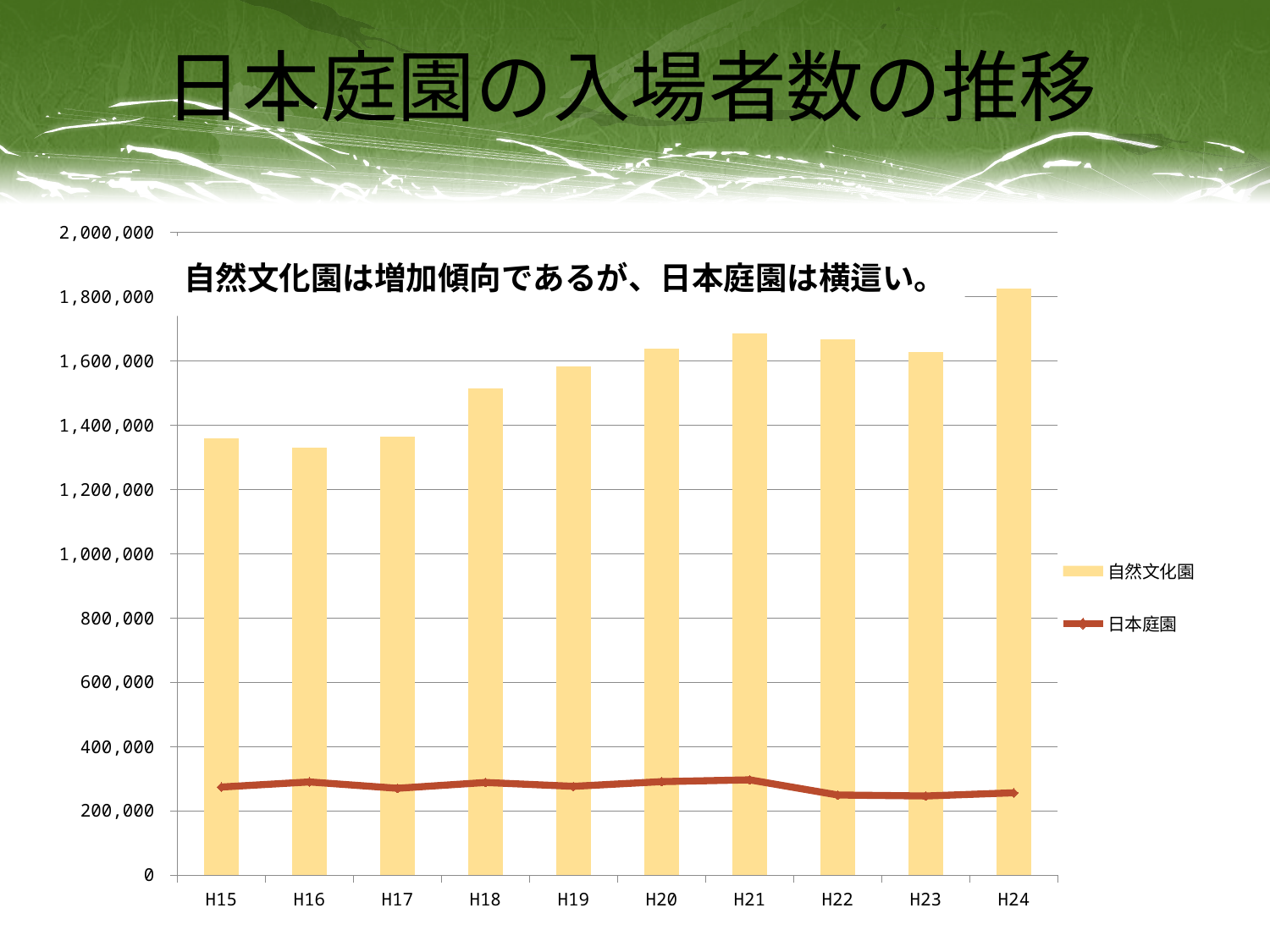
Which series is drawn as a line in the chart? 日本庭園 Is the value for 日本庭園 in H22 greater or less than 200,000? greater How many series does the legend list? 2 Which is larger, the 自然文化園 value in H19 or in H20? H20 Is the value for 自然文化園 in H18 greater or less than 1,400,000? greater How many categories (years) are shown on the x axis? 10 Is the value for 日本庭園 in H21 greater or less than 400,000? less Do the 自然文化園 values generally rise or fall from H15 to H24? rise Which year has the highest value for 自然文化園? H24 What kind of chart is shown on the slide? A combination of a bar chart and a line chart